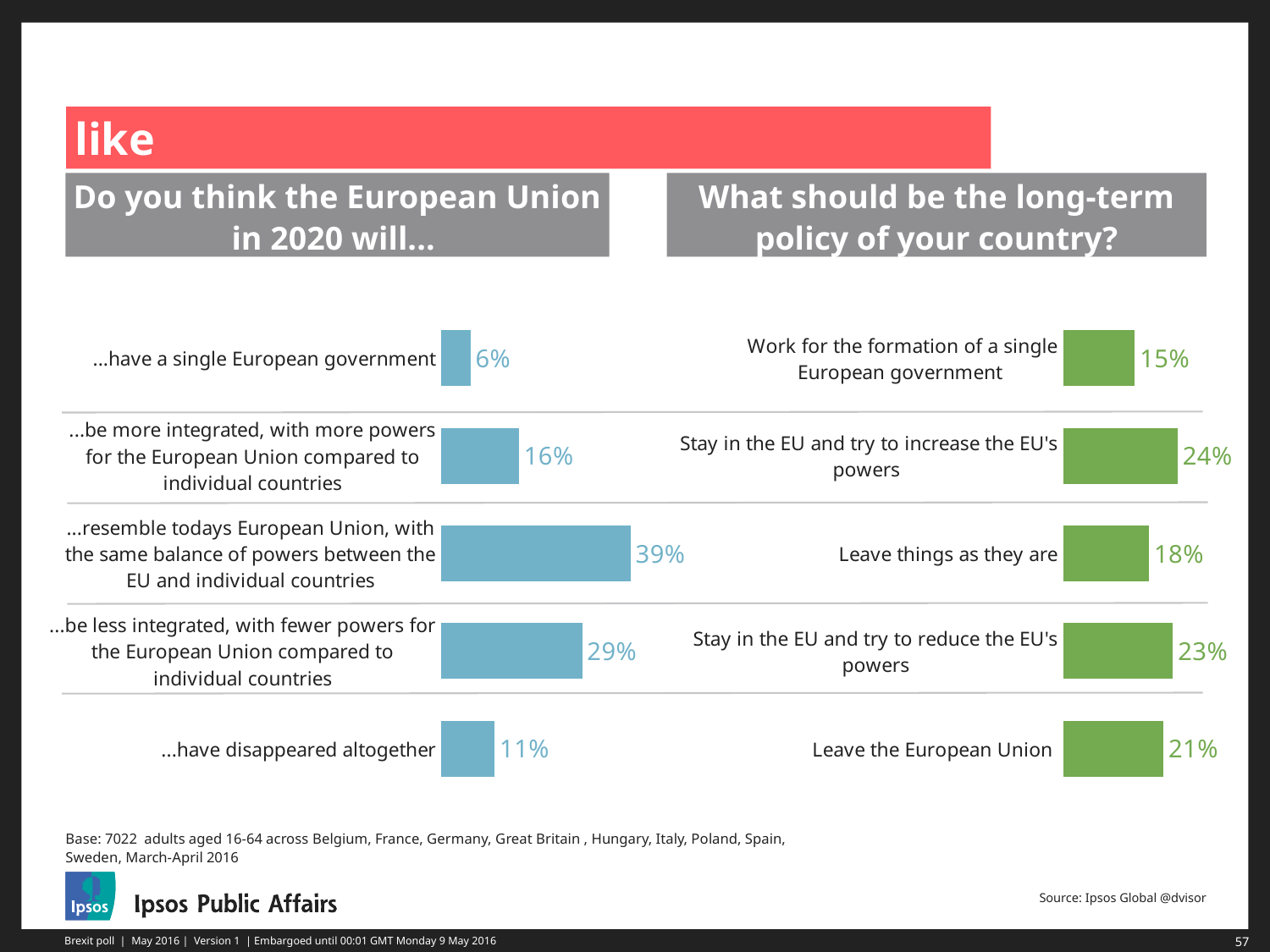
In the chart 'What should be the long-term policy of your country?', what is the value for 'Work for the formation of a single European government'? 15% In the chart 'Do you think the European Union in 2020 will...', what is the value for '...resemble todays European Union, with the same balance of powers between the EU and individual countries'? 39% In the chart 'What should be the long-term policy of your country?', which category has the highest value? Stay in the EU and try to increase the EU's powers In the chart 'What should be the long-term policy of your country?', what is the difference between 'Stay in the EU and try to increase the EU's powers' and 'Work for the formation of a single European government'? 9% In the chart 'Do you think the European Union in 2020 will...', what is the difference between '...resemble todays European Union' and '...be less integrated'? 10% In the chart 'Do you think the European Union in 2020 will...', how many categories are shown? 5 In the chart 'What should be the long-term policy of your country?', what is the value for 'Leave the European Union'? 21% In the chart 'What should be the long-term policy of your country?', which is larger: 'Leave things as they are' or 'Stay in the EU and try to reduce the EU's powers'? Stay in the EU and try to reduce the EU's powers What kind of chart is used on the left side of the slide, 'Do you think the European Union in 2020 will...'? Bar chart What colour are the bars in the chart 'What should be the long-term policy of your country?'? Green In the chart 'Do you think the European Union in 2020 will...', what is the value for '...have disappeared altogether'? 11% In the chart 'Do you think the European Union in 2020 will...', which category has the lowest value? ...have a single European government